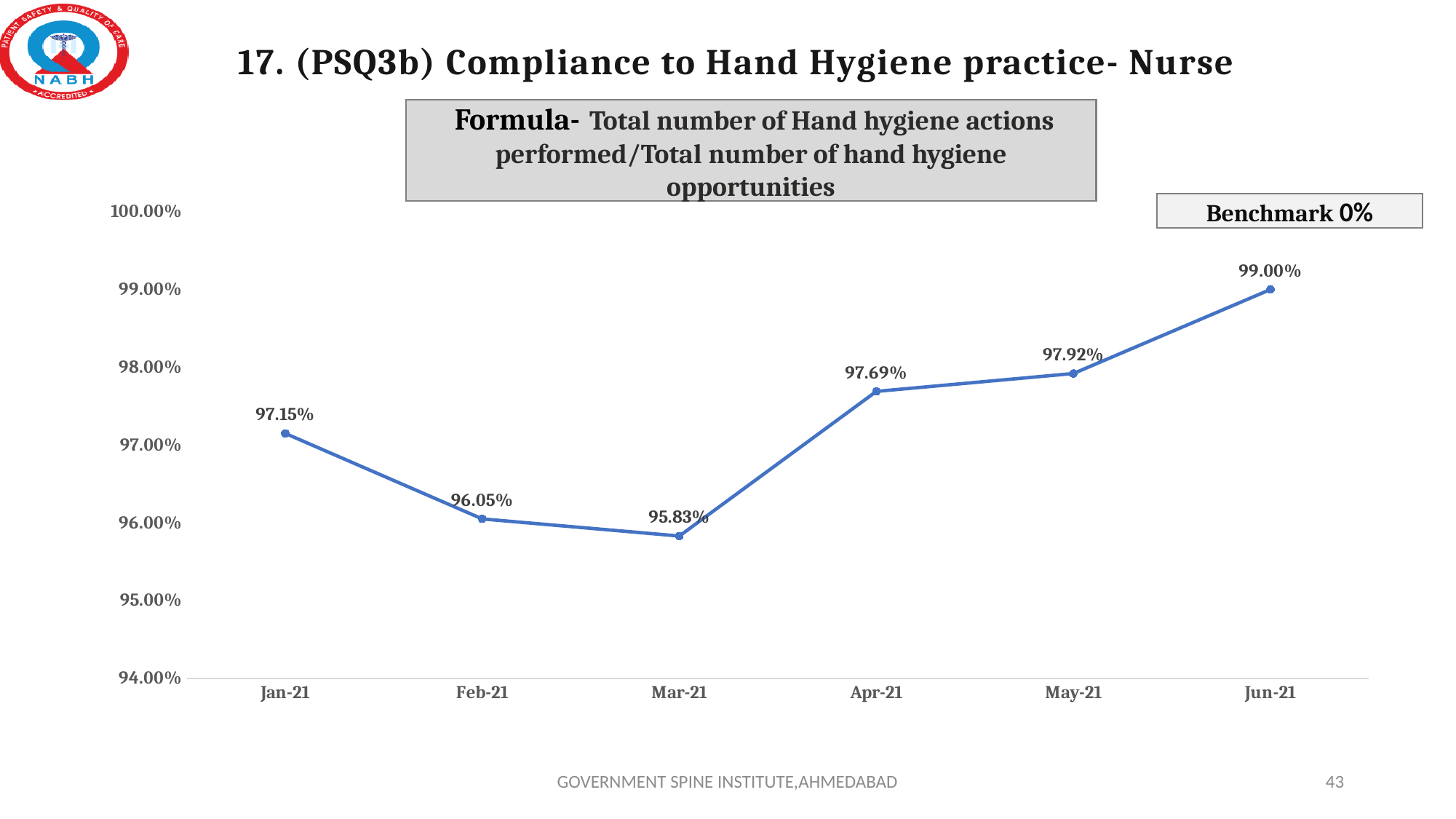
What is the hand hygiene compliance value for Jan-21? 97.15% Do the values rise or fall from Mar-21 to Jun-21? rise What is the value plotted for Jun-21? 99.00% Which month has the lowest compliance value? Mar-21 How many months are plotted on the x axis? 6 Is the value for Apr-21 greater or less than 97.00%? greater Which month has the highest compliance value? Jun-21 What is the difference between the Jun-21 and Mar-21 values? 3.17% What is the difference between the May-21 and Apr-21 values? 0.23% Which is larger, the value for Jan-21 or the value for Feb-21? Jan-21 What is the value plotted for Mar-21? 95.83% What kind of chart is shown on the slide? line chart